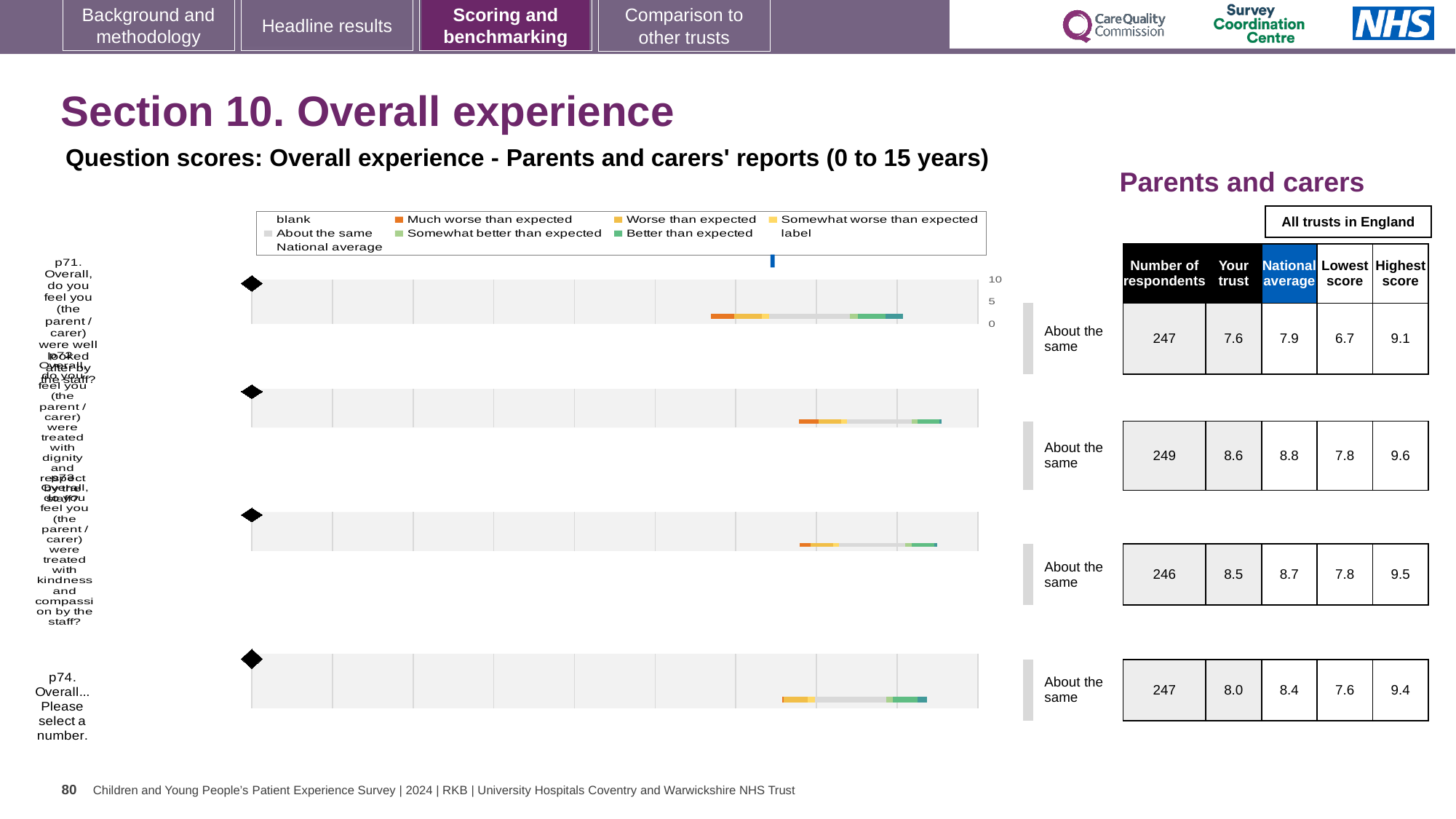
How many entries does the chart legend list? 9 What is the national average for p74 (Overall... Please select a number)? 8.4 What is the 'Your trust' score for p71 (Overall, do you feel you were well looked after by the staff)? 7.6 What is the difference between the national average and the 'Your trust' score for p71? 0.3 Which question has the highest 'Your trust' score? p72 Is the 'Your trust' score for p71 greater or less than 5? greater How many questions (categories) are plotted in the chart? 4 Which has the higher 'Your trust' score, p72 or p74? p72 What is the highest score across all trusts in England for p73? 9.5 What kind of chart is shown on the slide? bar chart How many respondents answered p72? 249 Which question has the lowest 'Your trust' score? p71